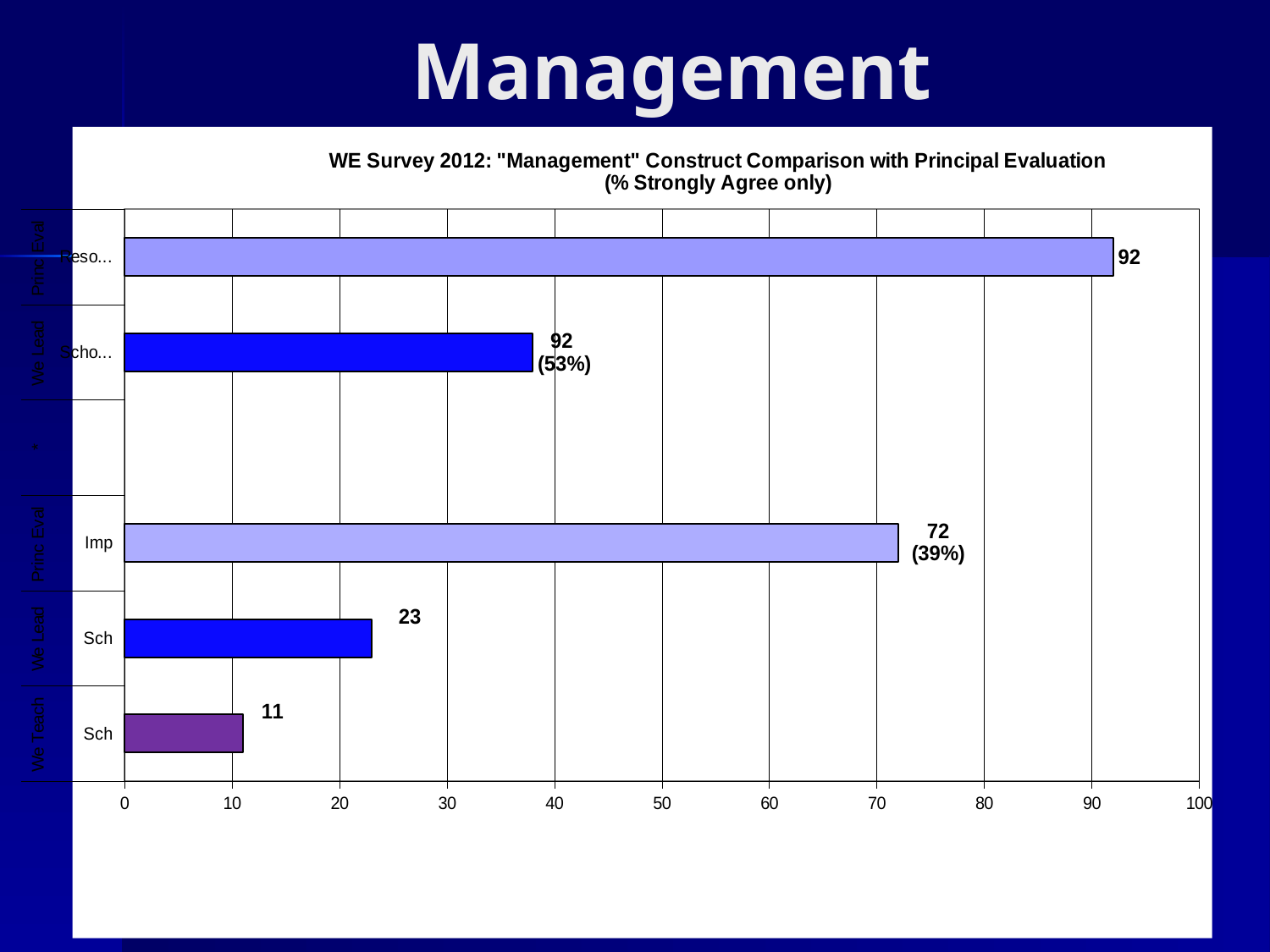
What is the value printed for the 'Imp' bar? 72 (39%) What kind of chart is shown on the slide? bar chart Which bar has the lowest value? Sch (We Teach), 11 How many bars are plotted in the chart? 5 What is the value printed for the 'Sch' bar in the 'We Lead' group (second from the bottom)? 23 What is the difference between the 'Imp' bar (72) and the 'Sch' bar in the 'We Lead' group (23)? 49 What is the value printed for the bottom 'Sch' bar in the 'We Teach' group? 11 Is the value for the 'Imp' bar greater or less than 50? greater Which is larger, the 'Imp' bar or the 'Sch' bar in the 'We Lead' group? Imp What is the difference between the 'Sch' bar in the 'We Lead' group (23) and the 'Sch' bar in the 'We Teach' group (11)? 12 What is the value printed for the topmost bar ('Reso...')? 92 What is the title of the chart? WE Survey 2012: "Management" Construct Comparison with Principal Evaluation (% Strongly Agree only)